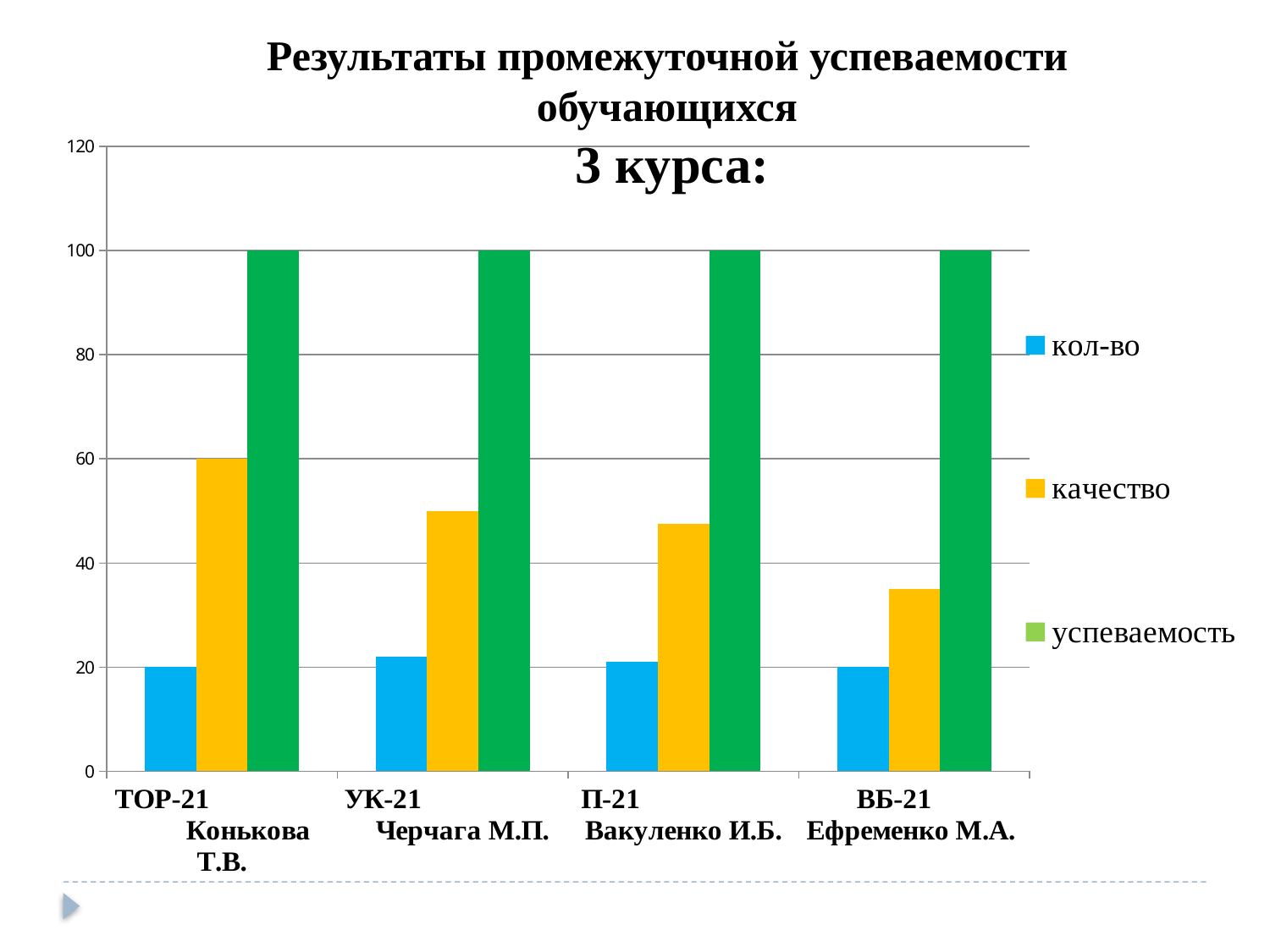
Which group has the lowest value for качество? ВБ-21 Is the value of качество for ВБ-21 greater or less than 40? less Which series is shown in green in the legend? успеваемость Which group has the highest value for качество? ТОР-21 What is the value of качество for ТОР-21? 60 Which is larger: качество for ТОР-21 or качество for ВБ-21? ТОР-21 What kind of chart is shown on the slide? bar chart What is the value of успеваемость for ТОР-21? 100 How many groups (categories) are shown on the x axis? 4 Is the value of качество for УК-21 greater or less than 40? greater What is the value of кол-во for ТОР-21? 20 How many series does the legend list? 3